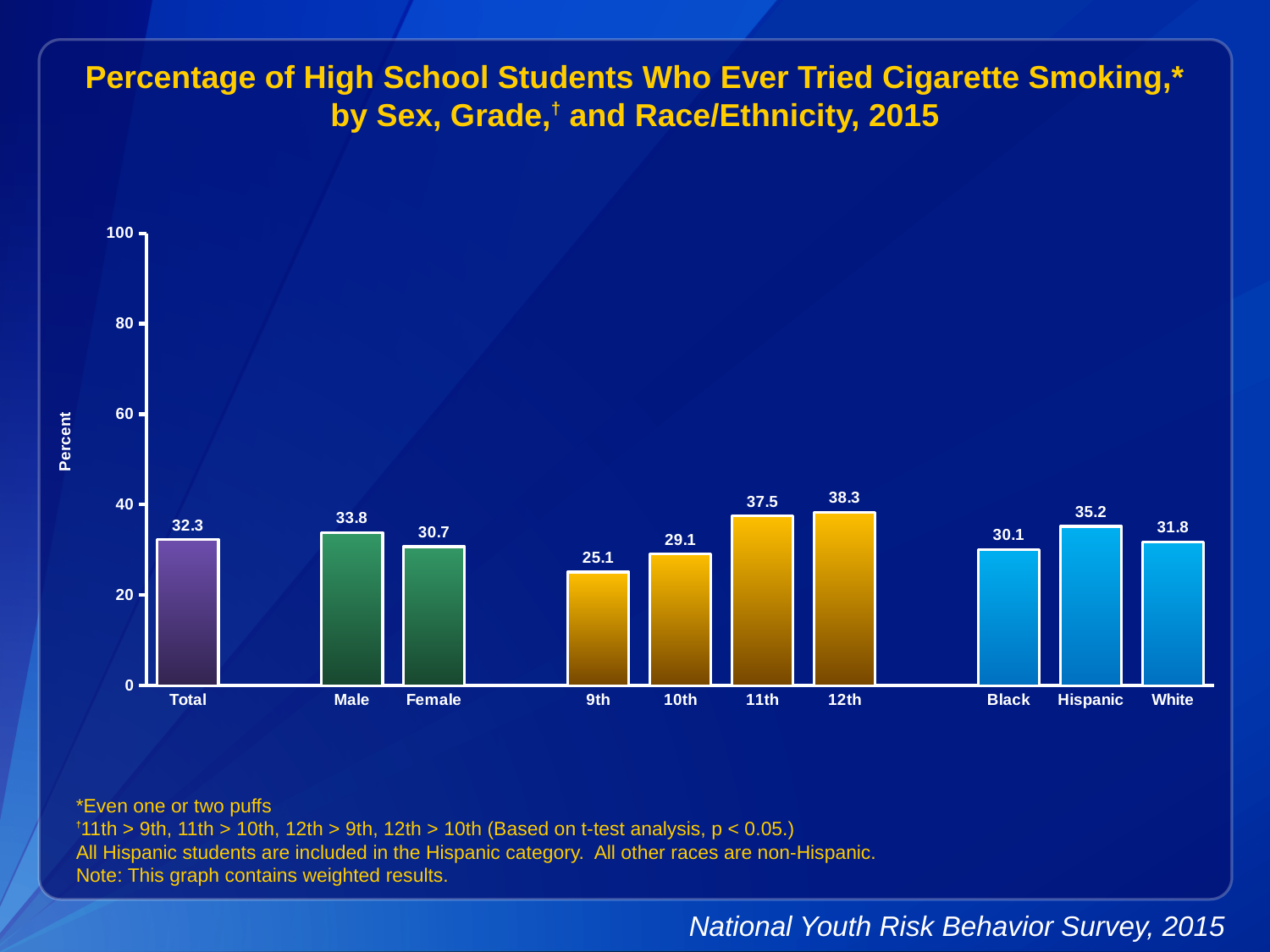
What is the value for Total? 32.3 What is the value for Female? 30.7 Which category has the lowest value? 9th What is the value for Hispanic? 35.2 What is the difference between the values for Male and Female? 3.1 Do the values rise or fall from 9th grade to 12th grade? rise Which category has the highest value? 12th Is the value for 11th grade greater or less than 40? less How many bars are shown in the chart? 10 What kind of chart is this? bar chart Which is larger, the value for Black or the value for White? White What is the value for 12th grade? 38.3